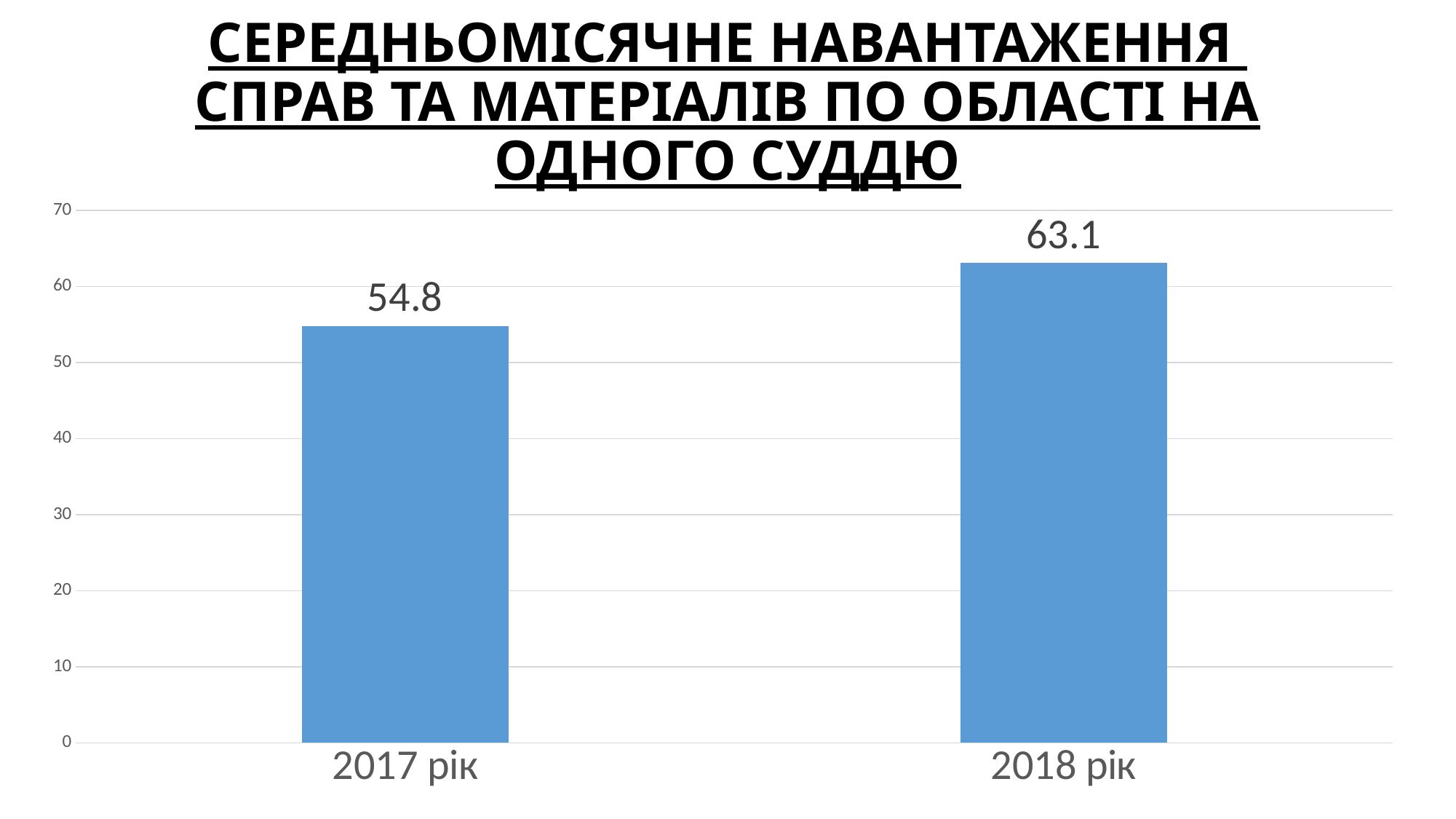
Is the value for 2017 рік greater or less than 60? less What is the difference between the values for 2018 рік and 2017 рік? 8.3 What colour are the bars on the chart? blue How many categories are shown on the chart? 2 Is the value for 2018 рік greater or less than 60? greater What is the value for 2018 рік? 63.1 Which is larger, the value for 2017 рік or the value for 2018 рік? 2018 рік What kind of chart is shown on the slide? bar chart What is the value for 2017 рік? 54.8 Do the values rise or fall from 2017 рік to 2018 рік? rise Which year has the highest value? 2018 рік Which year has the lowest value? 2017 рік